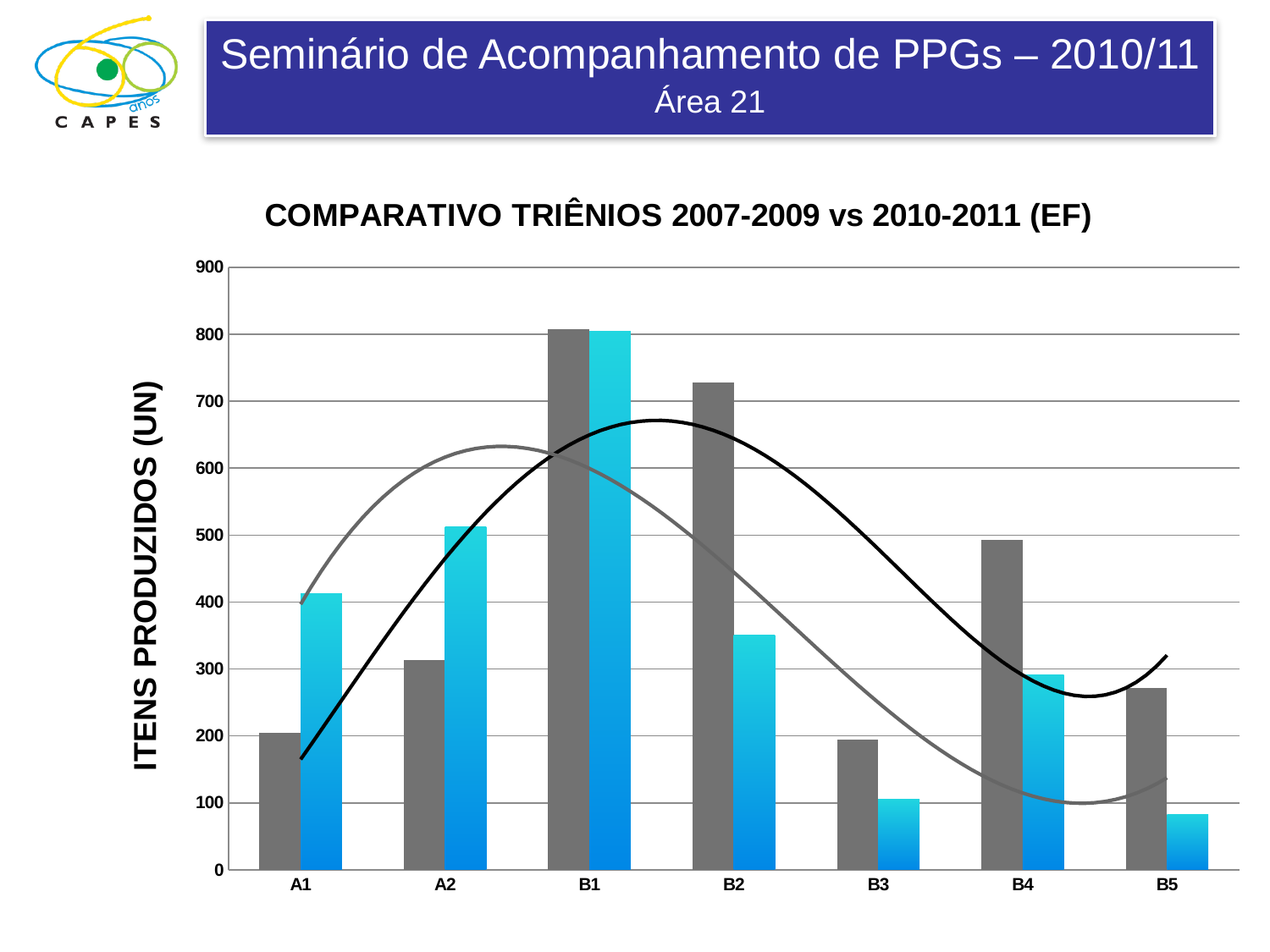
Is the gray bar for B4 greater or less than 400? greater What kind of chart is shown on the slide? bar chart How many categories are shown on the x axis of the chart? 7 For category A1, which bar is taller, the gray bar or the cyan bar? the cyan bar For category B2, which bar is taller, the gray bar or the cyan bar? the gray bar Which category has the tallest gray bar? B1 Is the gray bar for B2 greater or less than 700? greater Which category has the shortest cyan bar? B5 Which category has the tallest cyan bar? B1 What is the title of the chart? COMPARATIVO TRIÊNIOS 2007-2009 vs 2010-2011 (EF) Is the cyan bar for B3 greater or less than 200? less What is the label of the vertical axis of the chart? ITENS PRODUZIDOS (UN)